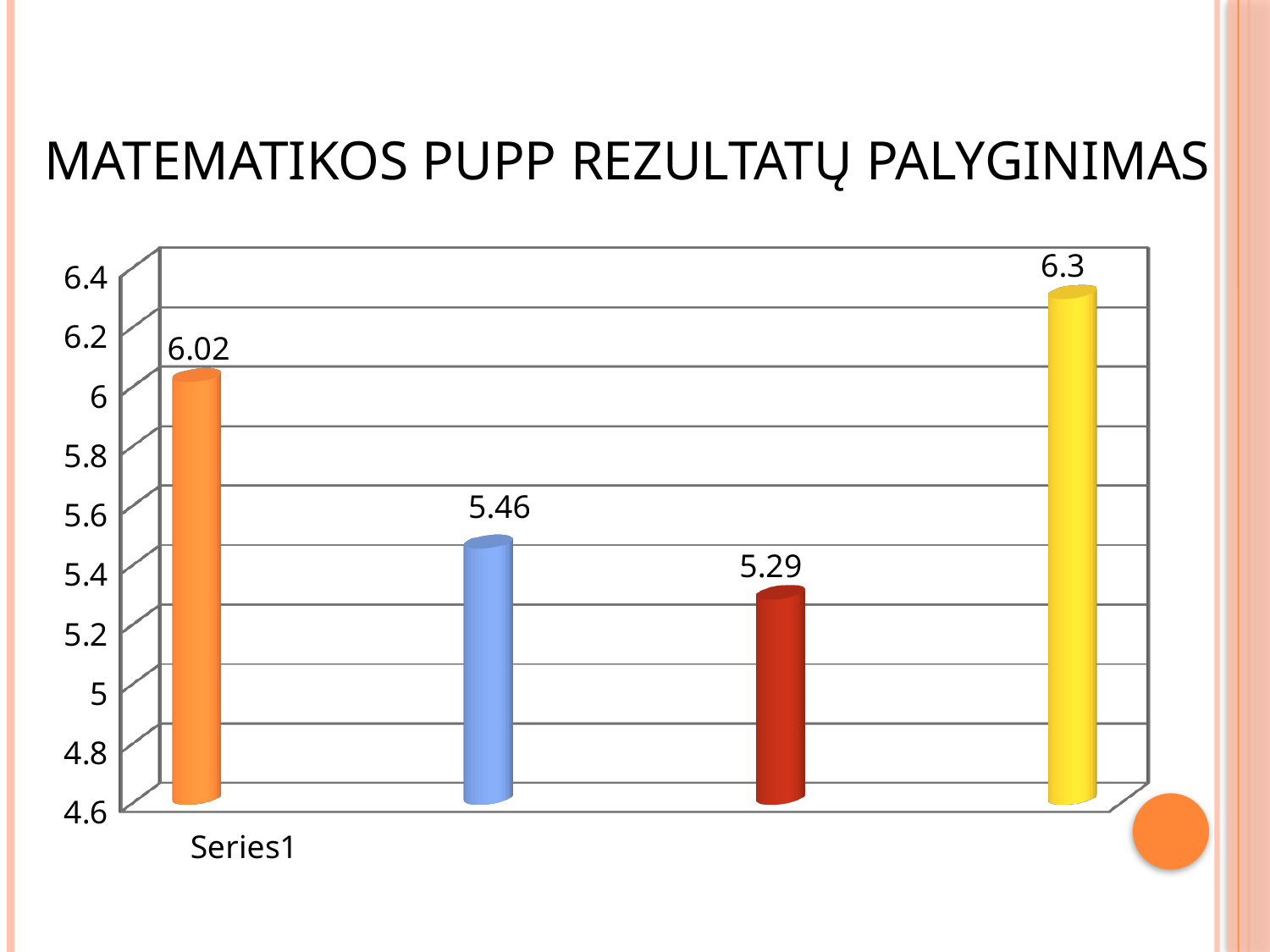
How many bars are plotted in the chart? 4 What is the value of the first (orange) bar from the left? 6.02 What is the value of the fourth (yellow) bar from the left? 6.3 What is the difference between the yellow bar (6.3) and the red bar (5.29)? 1.01 What type of chart is shown on the slide? bar chart What label is shown under the x axis of the chart? Series1 Which bar has the lowest value? the third (red) bar, 5.29 Which bar has the highest value? the fourth (yellow) bar, 6.3 Which is larger, the orange bar or the blue bar? the orange bar What is the value of the third (red) bar from the left? 5.29 What is the title of the slide above the chart? MATEMATIKOS PUPP REZULTATŲ PALYGINIMAS What is the value of the second (blue) bar from the left? 5.46